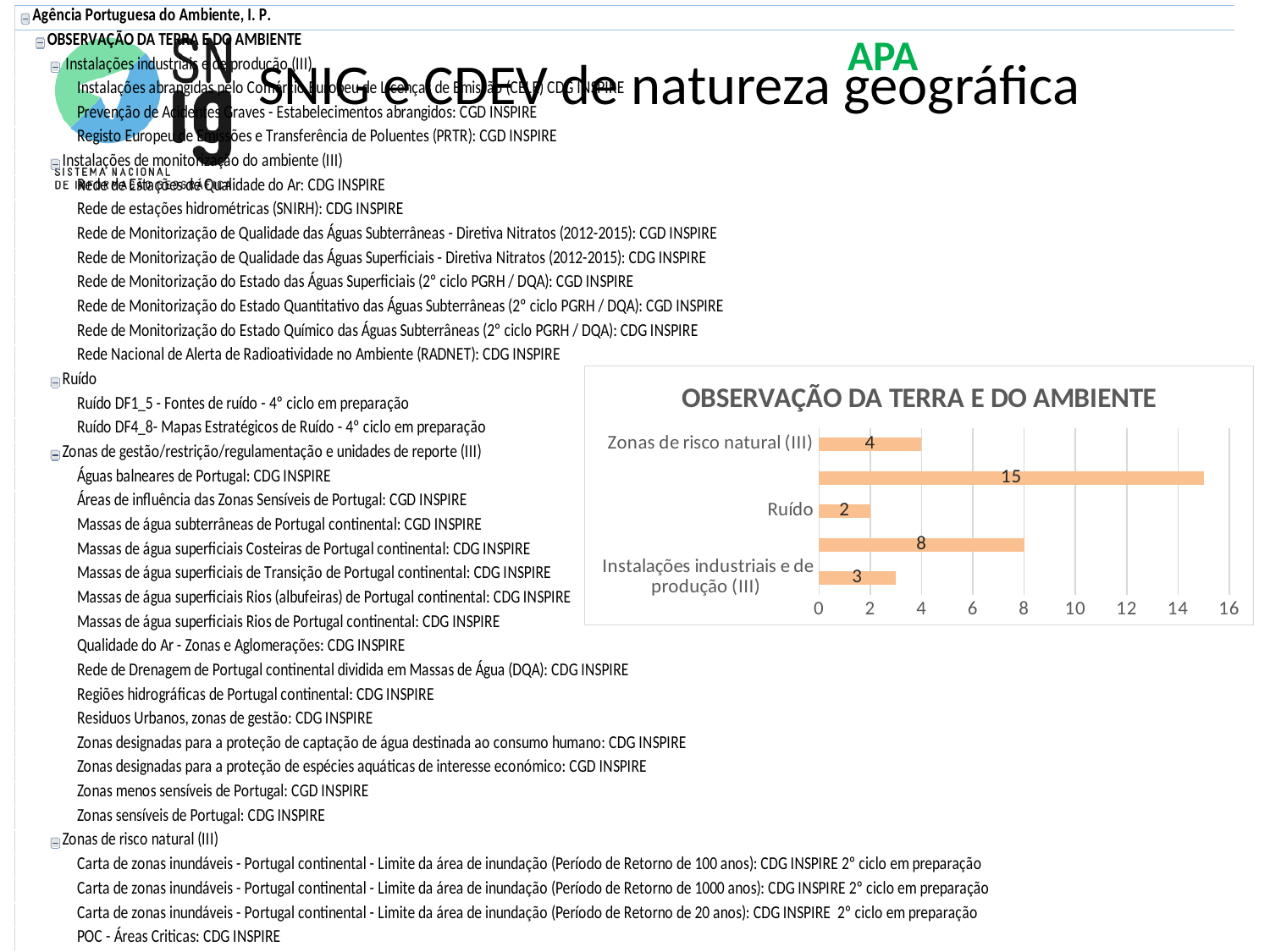
What is the value for Zonas de risco natural (III)? 4 What is the maximum value shown on the horizontal axis? 16 What is the difference between the values for Zonas de risco natural (III) and Ruído? 2 Which is larger, the value for Zonas de risco natural (III) or the value for Instalações industriais e de produção (III)? Zonas de risco natural (III) How many bars are plotted in the chart? 5 What type of chart is shown on the slide? bar chart Is the value for Ruído greater or less than 4? less What is the title of the chart? OBSERVAÇÃO DA TERRA E DO AMBIENTE What is the largest value plotted in the chart? 15 Which labelled category has the lowest value? Ruído What is the value for Instalações industriais e de produção (III)? 3 What is the value for Ruído? 2